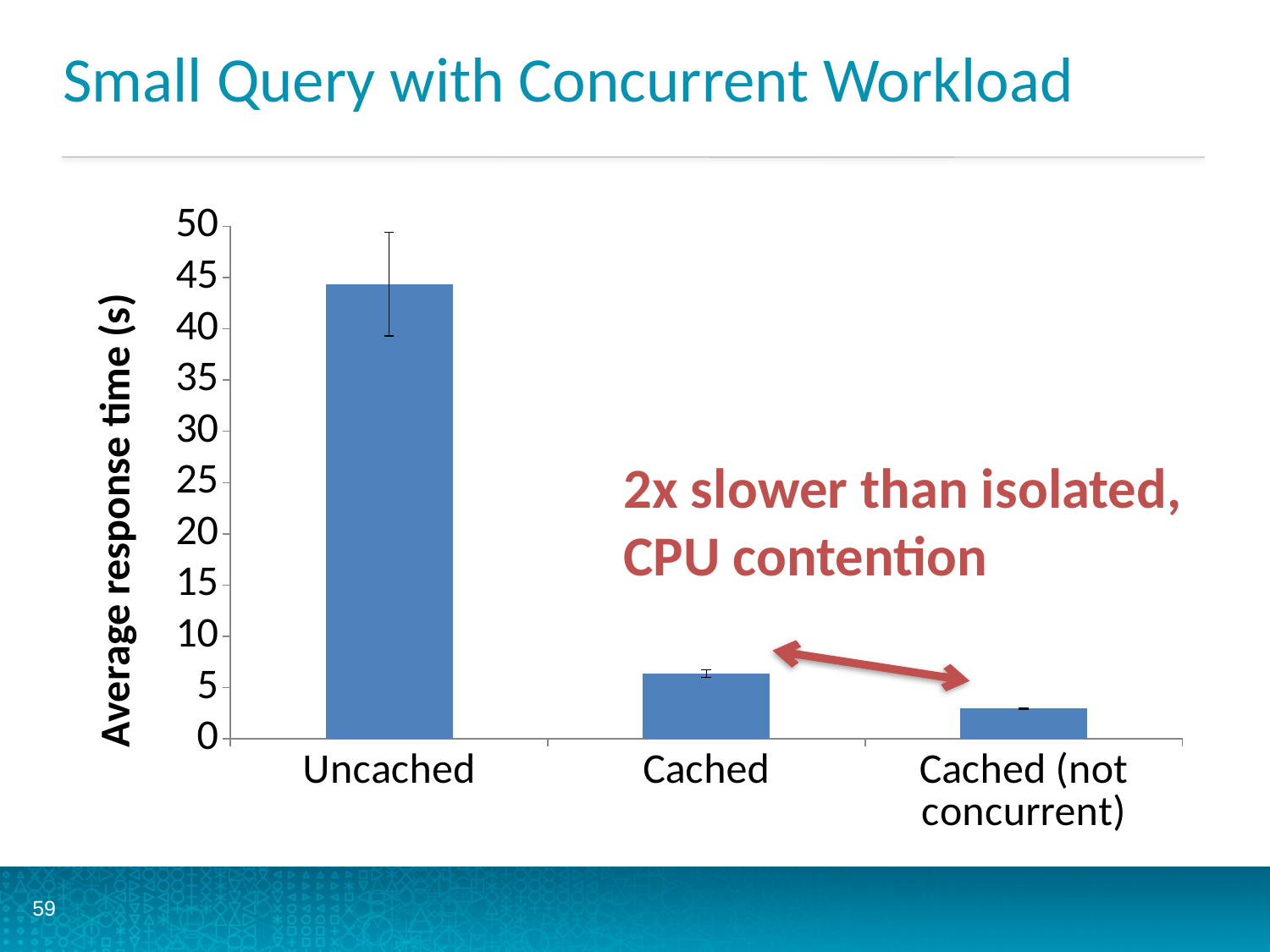
Is the value for Cached (not concurrent) greater or less than 5? less Is the value for Cached greater or less than 10? less Which is larger, the value for Cached or the value for Cached (not concurrent)? Cached Is the value for Uncached greater or less than 40? greater How many categories are shown on the x axis? 3 Which category has the lowest average response time? Cached (not concurrent) Do the values rise or fall from left to right along the x axis? fall What is the label of the y axis? Average response time (s) What is the title of the slide containing the chart? Small Query with Concurrent Workload What type of chart is shown on the slide? bar chart Which category has the highest average response time? Uncached